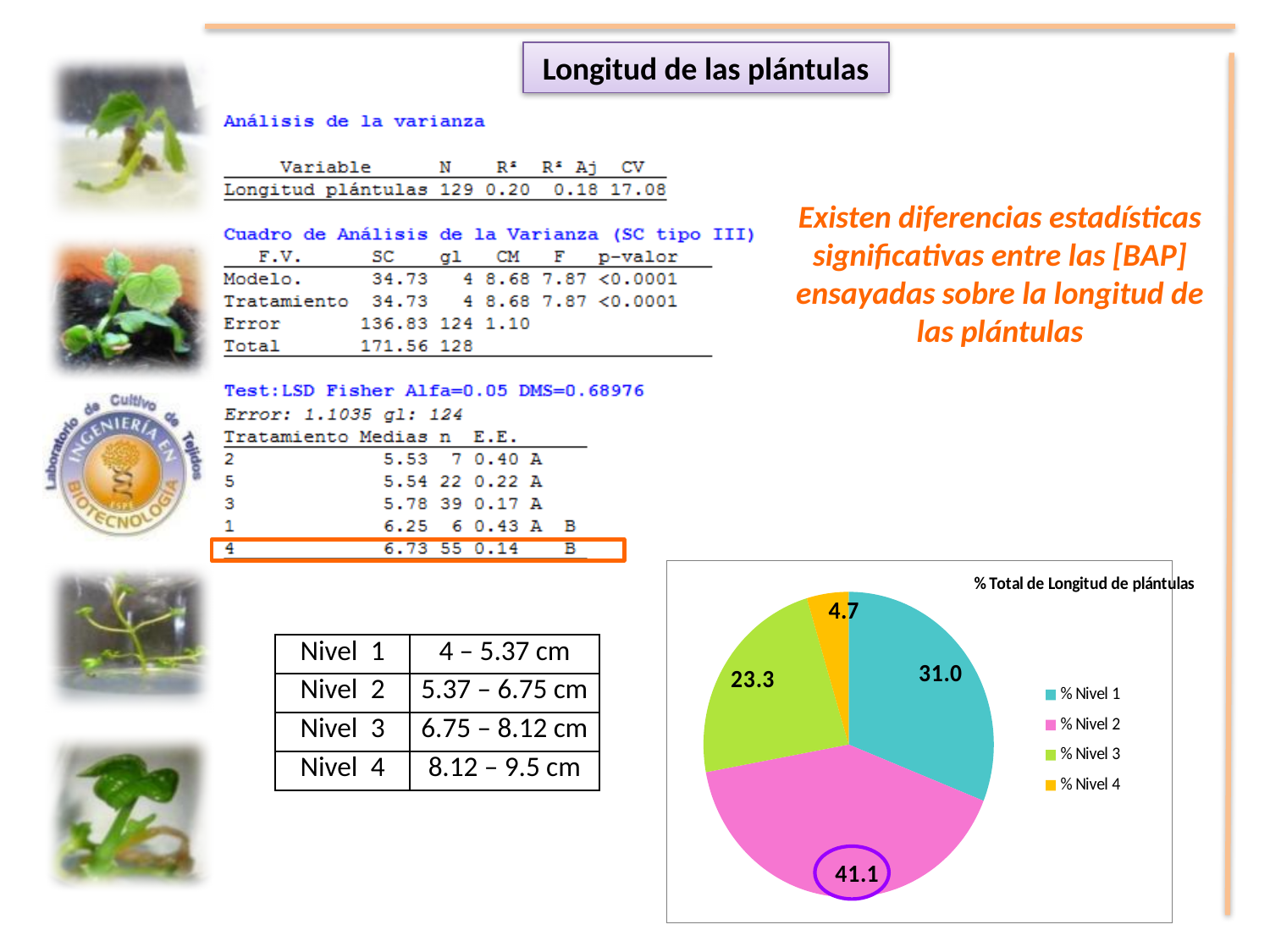
What is the title of the pie chart? % Total de Longitud de plántulas What kind of chart is shown on the slide? pie chart What is the value for % Nivel 4 in the pie chart? 4.7 What is the value for % Nivel 1 in the pie chart? 31.0 Which slice of the pie chart is the largest? % Nivel 2 Which is larger in the pie chart, % Nivel 3 or % Nivel 4? % Nivel 3 Which slice of the pie chart is the smallest? % Nivel 4 What is the difference between the values for % Nivel 2 and % Nivel 1 in the pie chart? 10.1 How many slices does the pie chart have? 4 How many entries does the legend of the pie chart list? 4 What is the value for % Nivel 2 in the pie chart? 41.1 What is the value for % Nivel 3 in the pie chart? 23.3